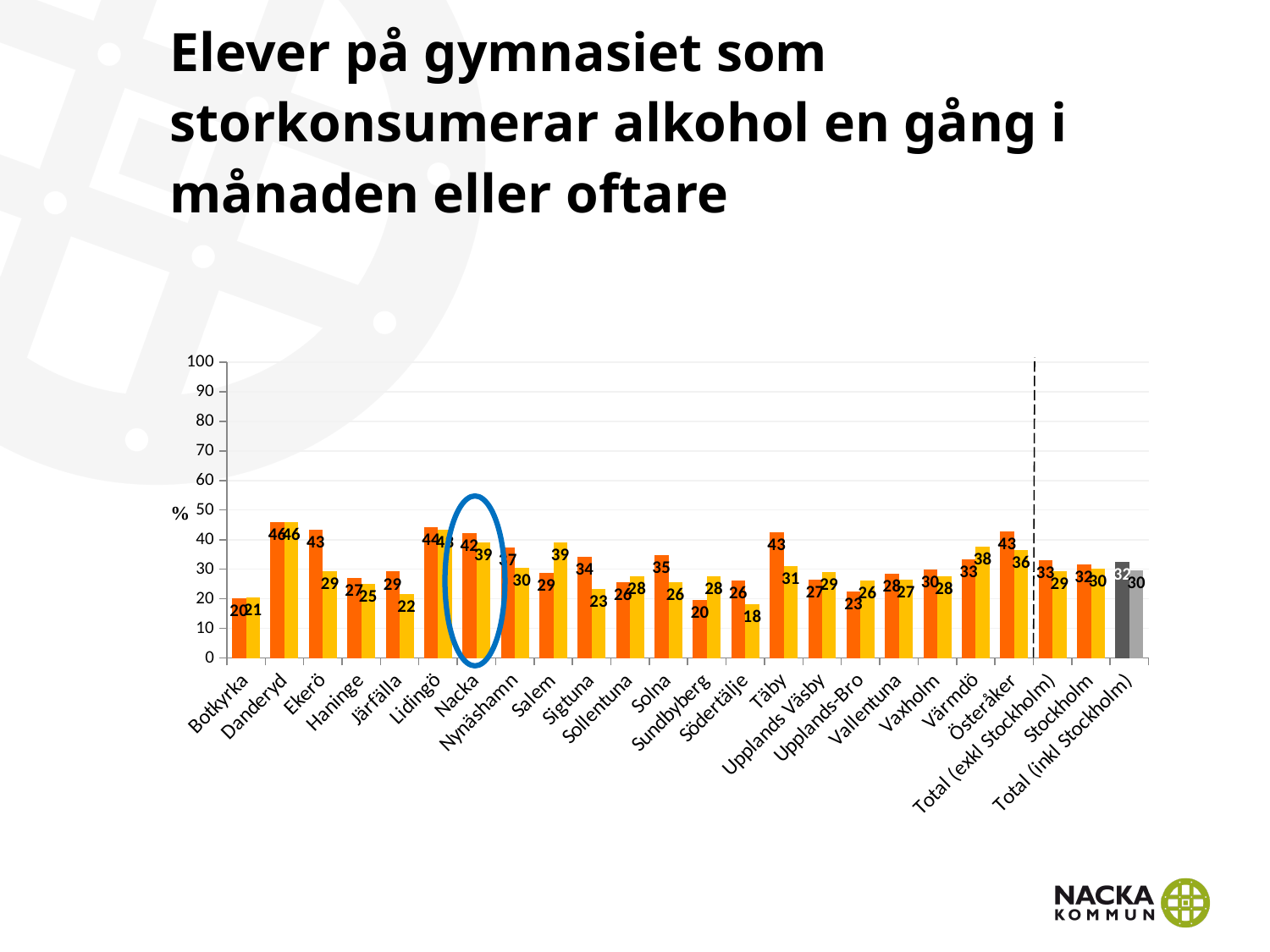
What is the value of the yellow bar for Nacka? 39 Which category has the lowest yellow bar in the chart? Södertälje What is the value of the yellow bar for Södertälje? 18 Which category has the highest value in the chart? Danderyd Is the value of the orange bar for Täby greater or less than 40? greater What is the value of the orange bar for Total (exkl Stockholm)? 33 What is the value of the orange bar for Nacka? 42 What type of chart is shown on the slide? bar chart Which is larger for Salem, the orange bar or the yellow bar? the yellow bar What is the difference between the orange bar and the yellow bar for Ekerö? 14 How many categories are shown along the x axis of the chart? 24 Which category on the chart is circled in blue? Nacka